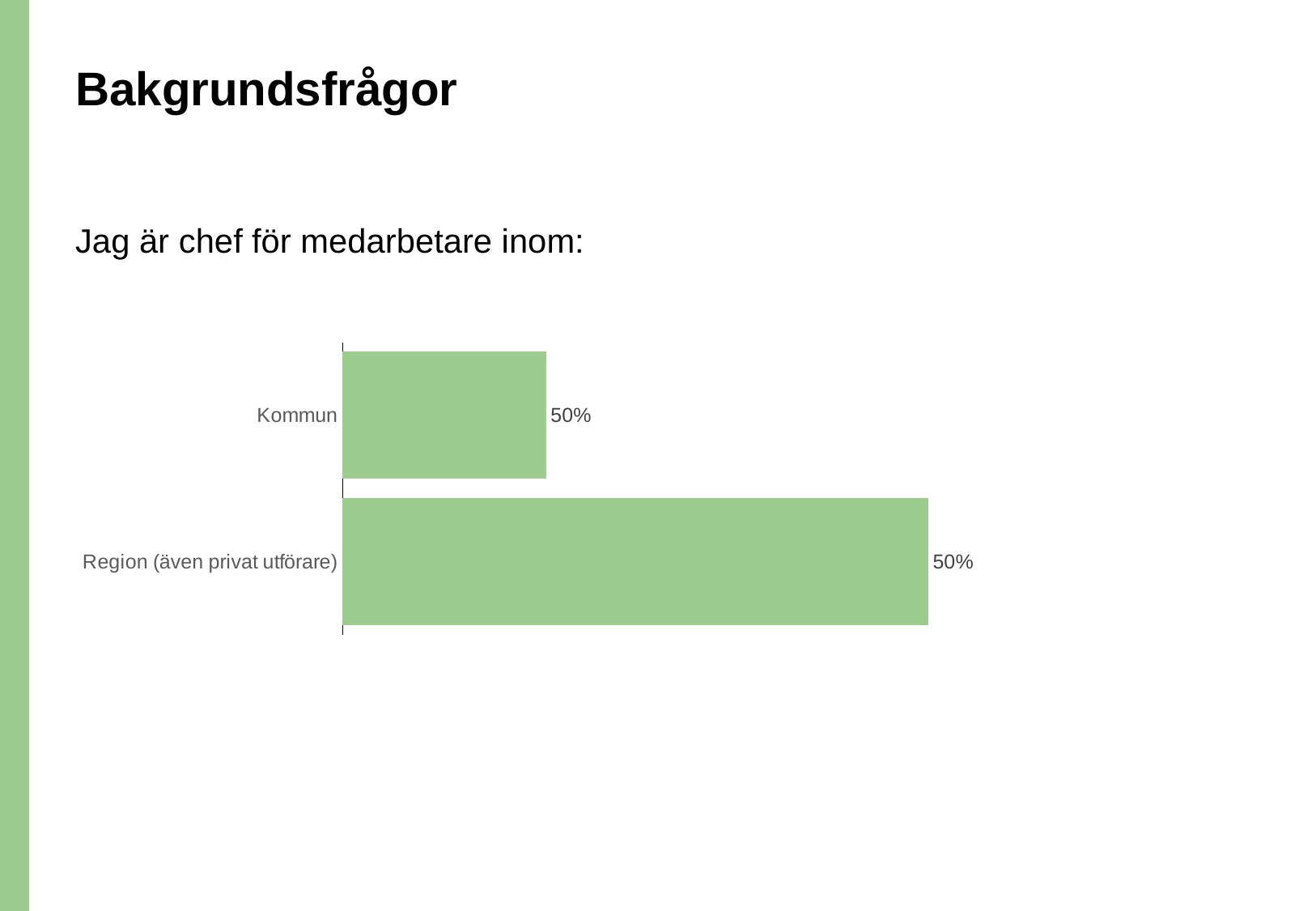
What is the sum of the labelled values for Kommun and Region (även privat utförare)? 100% Which category is listed first (at the top) in the chart? Kommun What is the value for Region (även privat utförare)? 50% How many categories are shown in the chart? 2 What kind of chart is shown on the slide? Bar chart What question does the chart on the slide answer? Jag är chef för medarbetare inom: What is the difference between the labelled values for Kommun and Region (även privat utförare)? 0% What colour are the bars in the chart? Green What is the value for Kommun? 50%